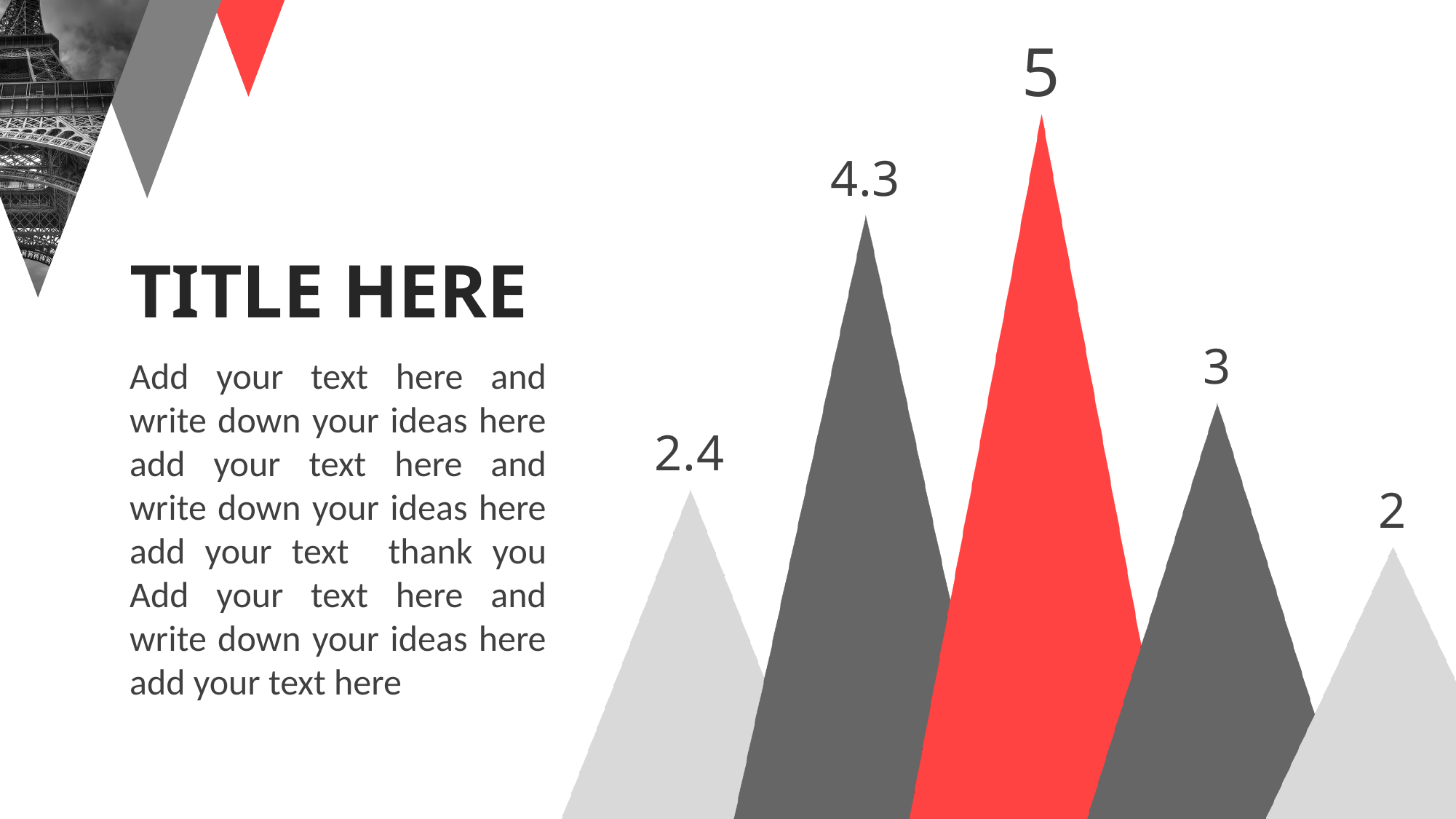
What is the title text shown on the slide next to the chart? TITLE HERE What is the lowest value shown in the chart? 2 What colour is the tallest peak in the chart? red What is the difference between the highest value (5) and the lowest value (2) in the chart? 3 What is the value of the second peak from the left in the chart? 4.3 What is the value of the red peak in the chart? 5 What is the difference between the second peak (4.3) and the first peak (2.4) in the chart? 1.9 What is the highest value shown in the chart? 5 What is the value of the leftmost peak in the chart? 2.4 What is the value of the rightmost peak in the chart? 2 Which is larger in the chart, the leftmost peak or the rightmost peak? the leftmost peak (2.4) How many data points are plotted in the chart? 5